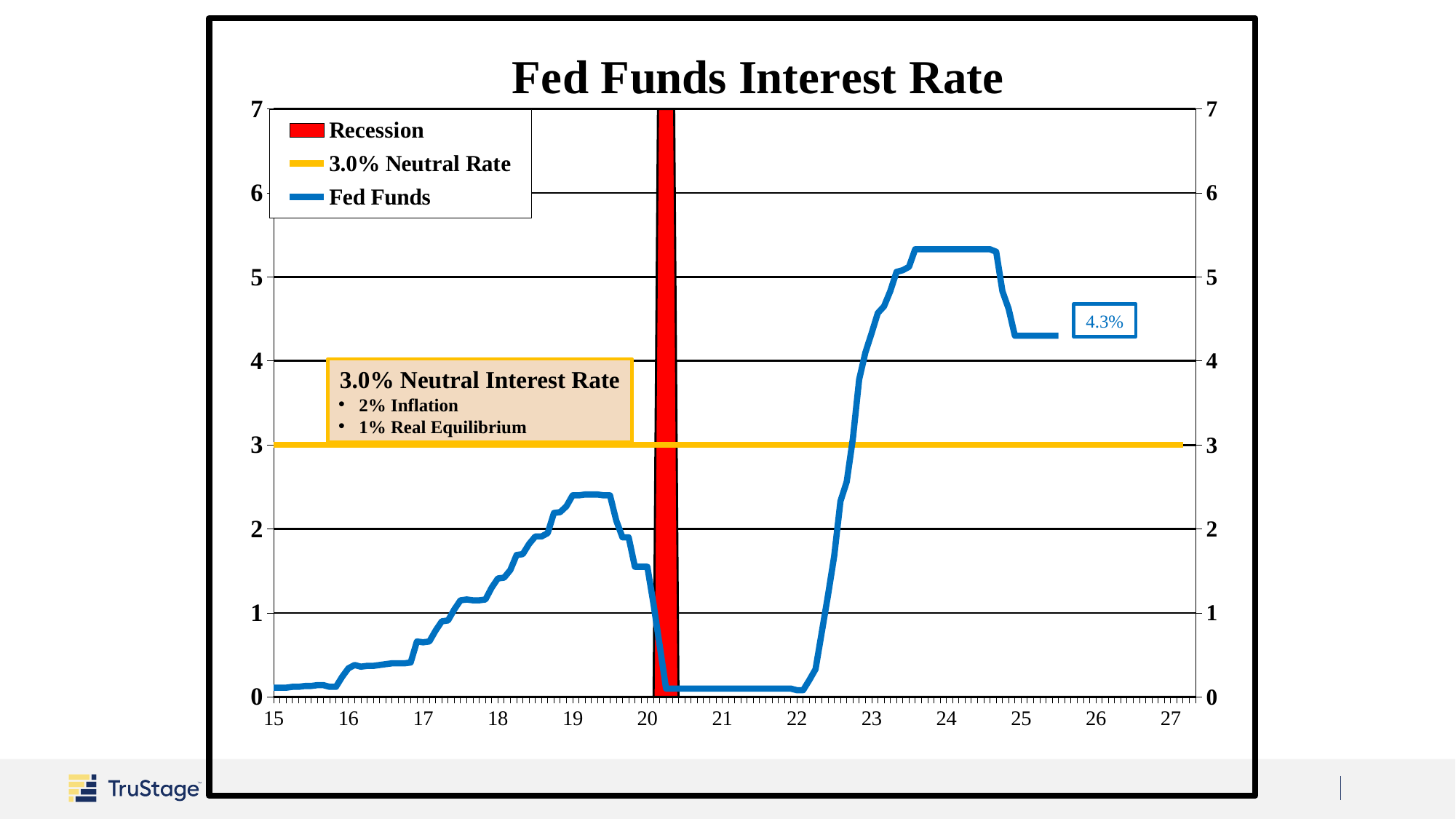
Does the Fed Funds line rise or fall between year 22 and year 23? rise What value is the neutral interest rate line set at, according to the legend? 3.0% Does the Fed Funds line rise or fall between year 19.5 and year 20.5? fall How many entries does the chart's legend list? 3 Is the Fed Funds value at year 21 greater or less than 1? less Is the Fed Funds value at year 24 greater or less than 5? greater What kind of chart is shown on the slide? line chart Which is larger: the Fed Funds value at year 24 or at year 19? year 24 What is the title of the chart? Fed Funds Interest Rate Is the Fed Funds value at year 19 greater or less than 2? greater What is the value shown in the data label at the end of the Fed Funds line? 4.3% What colour is used for the Recession entry in the legend? red